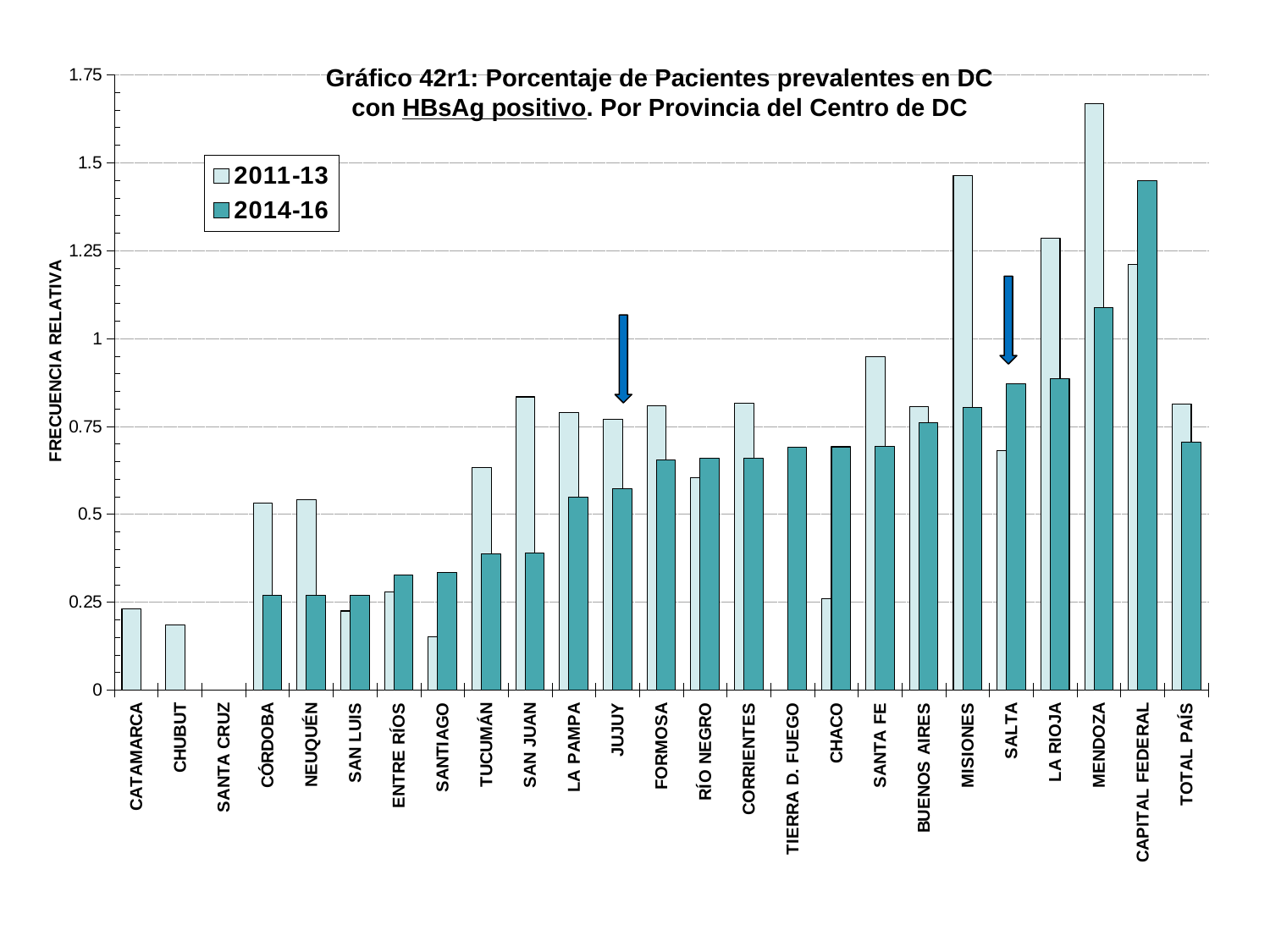
Which two provinces are marked with blue arrows on the chart? JUJUY and SALTA How many provinces/categories are shown along the x axis? 25 Is the 2014-16 value for JUJUY greater or less than 0.75? less Is the 2014-16 value for CAPITAL FEDERAL greater or less than 1.25? greater For TOTAL PAÍS, which series has the larger value, 2011-13 or 2014-16? 2011-13 Which category has the highest 2011-13 value? MENDOZA For SALTA, which series has the larger value, 2011-13 or 2014-16? 2014-16 What kind of chart is shown on the slide? bar chart How many series does the legend list? 2 Is the 2011-13 value for CHUBUT greater or less than 0.25? less Which category has the highest 2014-16 value? CAPITAL FEDERAL